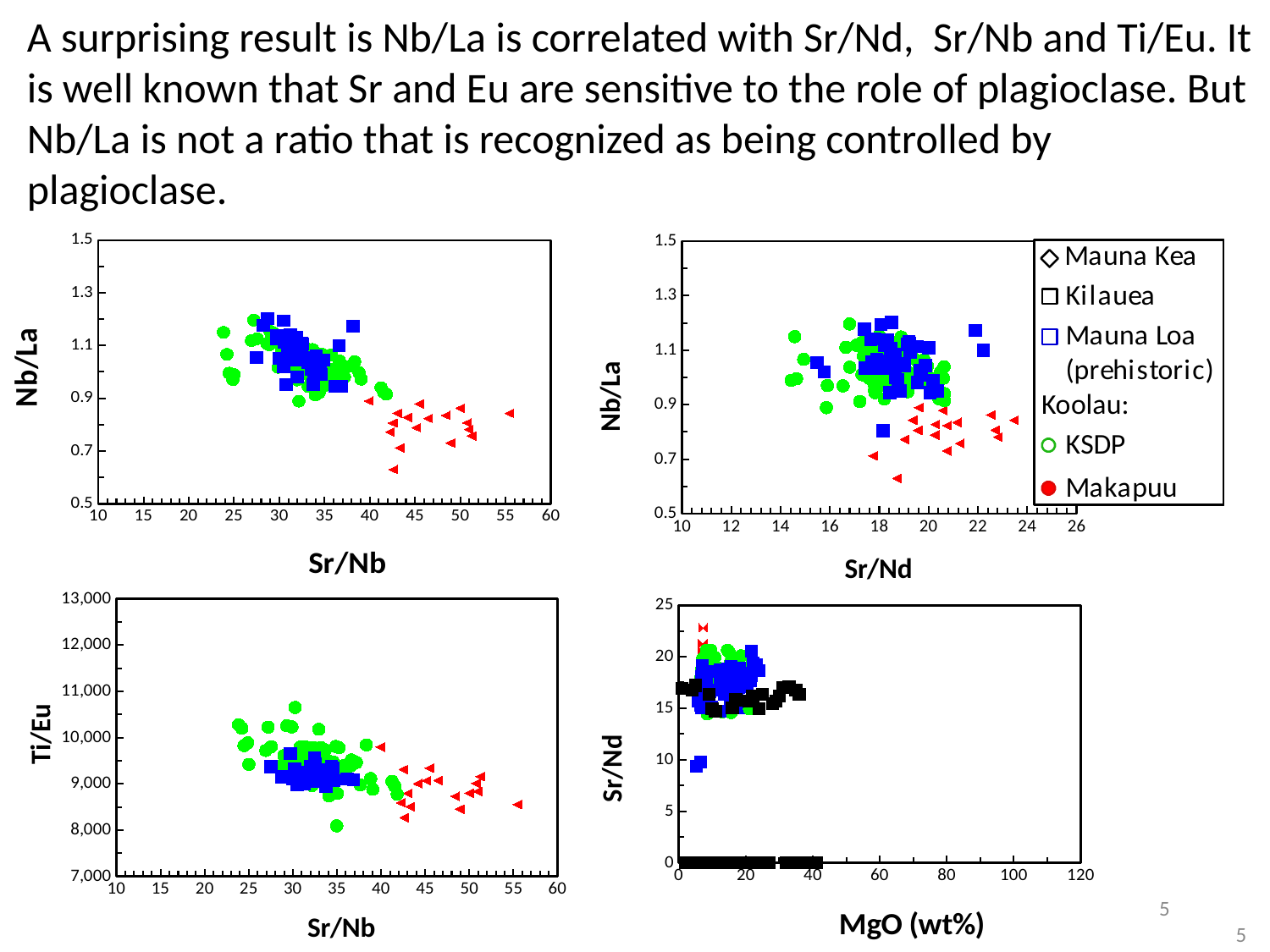
In the top-left chart, what is the label of the x axis? Sr/Nb In the top-right chart, what is the maximum value shown on the Sr/Nd axis? 26 In the bottom-left chart, does Ti/Eu rise or fall as Sr/Nb increases? Fall What kind of chart is the top-left chart (Nb/La vs Sr/Nb)? Scatter plot In the top-right chart, are the red Makapuu points at Nb/La values greater or less than 1.1? less In the top-left chart, are the red Makapuu points at Sr/Nb values greater or less than 40? greater In the bottom-right chart, what is the label of the x axis? MgO (wt%) In the bottom-right chart, is the highest Sr/Nd value plotted greater or less than 20? greater How many sample groups does the legend list? 5 In the top-left chart, does Nb/La rise or fall as Sr/Nb increases? Fall How many charts are shown on the slide? 4